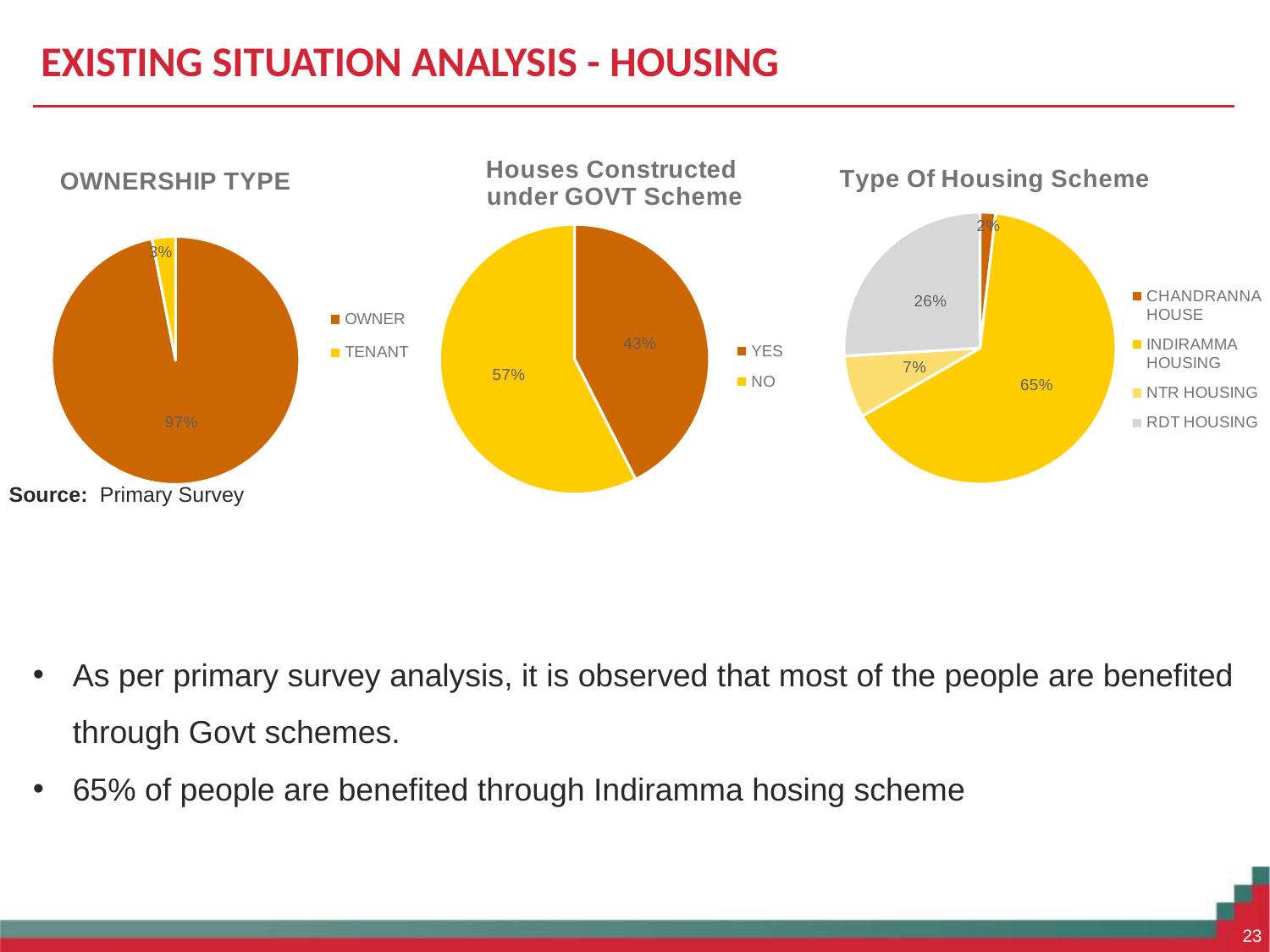
In the Houses Constructed under GOVT Scheme chart, which is larger, YES or NO? NO How many categories does the legend of the Type Of Housing Scheme chart list? 4 In the Type Of Housing Scheme chart, what is the difference between RDT HOUSING and NTR HOUSING? 19% In the Type Of Housing Scheme chart, what is the value for RDT HOUSING? 26% What kind of chart is the OWNERSHIP TYPE chart? Pie chart In the Type Of Housing Scheme chart, what is the value for INDIRAMMA HOUSING? 65% In the OWNERSHIP TYPE chart, what share of the pie is TENANT? 3% In the Houses Constructed under GOVT Scheme chart, what is the value for NO? 57% In the OWNERSHIP TYPE chart, what share of the pie is OWNER? 97% In the Houses Constructed under GOVT Scheme chart, what is the difference between NO and YES? 14% In the Houses Constructed under GOVT Scheme chart, what is the value for YES? 43% In the Type Of Housing Scheme chart, which scheme has the smallest share? CHANDRANNA HOUSE